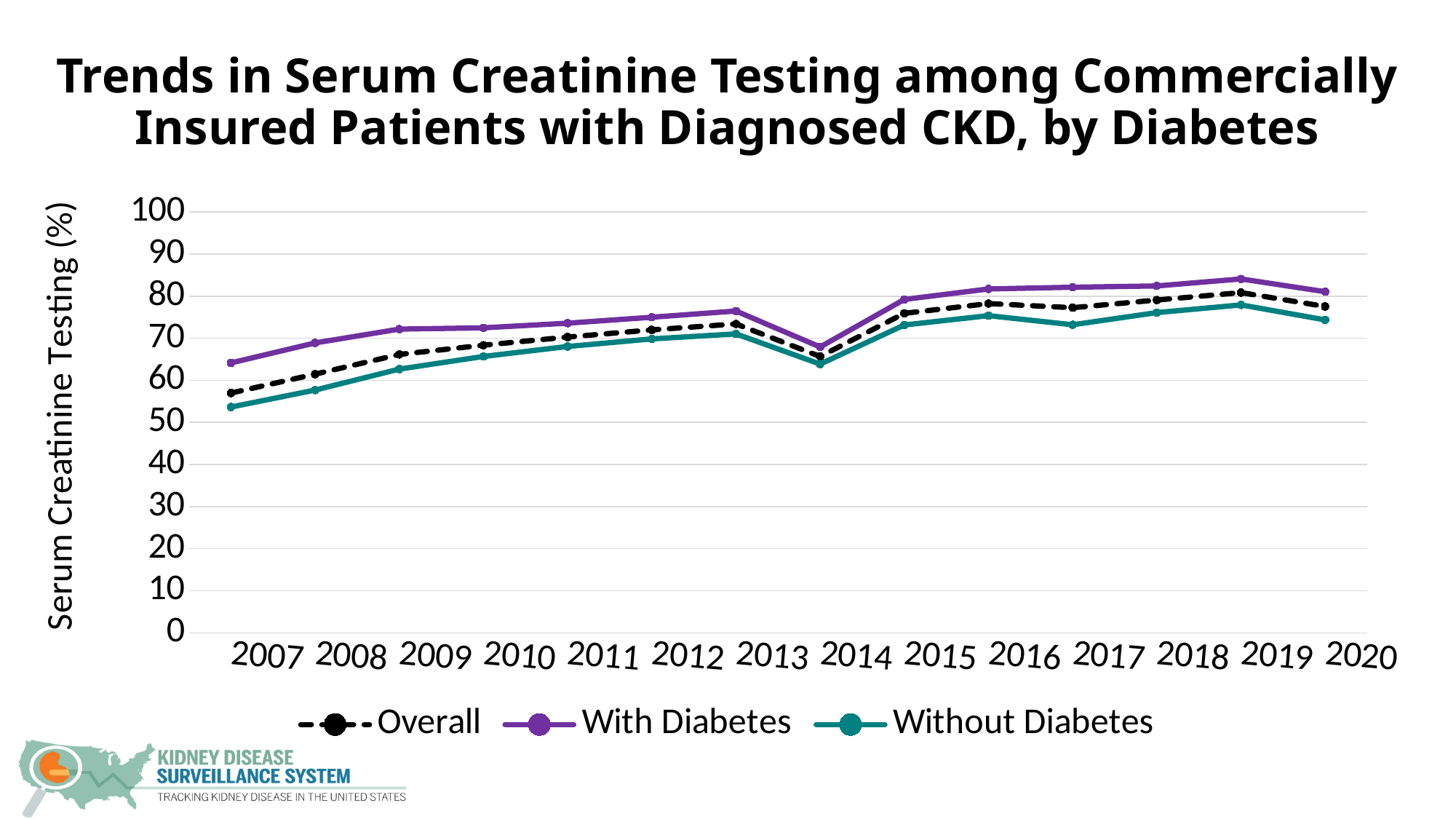
How many series does the legend list? 3 In which year is the Without Diabetes series at its lowest? 2007 Is the value for With Diabetes in 2019 greater or less than 80? greater Is the value for With Diabetes in 2007 greater or less than 60? greater Is the value for Without Diabetes in 2007 greater or less than 60? less In which year is the With Diabetes series at its highest? 2019 Does the Overall series rise or fall from 2007 to 2013? rise In 2014, which series has the higher value: With Diabetes or Without Diabetes? With Diabetes What kind of chart is shown on the slide? line chart How many years are plotted along the x axis? 14 What is the label of the y axis? Serum Creatinine Testing (%)